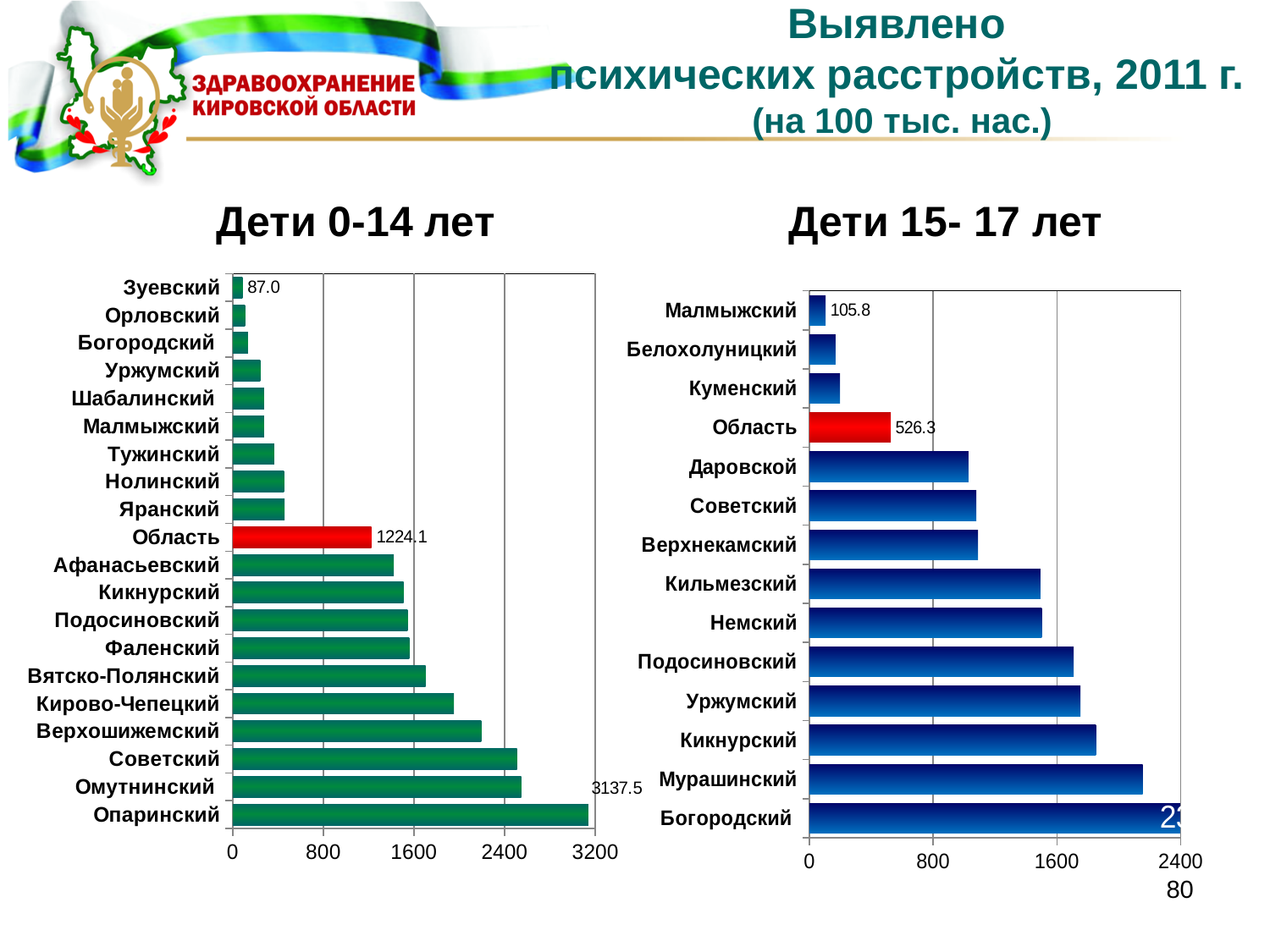
In the chart 'Дети 15- 17 лет', is the value for Даровской greater or less than 800? greater What kind of chart is 'Дети 15- 17 лет'? bar chart In the chart 'Дети 0-14 лет', what is the difference between the values for Опаринский and Зуевский? 3050.5 In the chart 'Дети 15- 17 лет', which category has the lowest value? Малмыжский In the chart 'Дети 0-14 лет', what is the value for Зуевский? 87.0 How many categories are shown in the chart 'Дети 0-14 лет'? 20 In the chart 'Дети 15- 17 лет', what is the value for Область? 526.3 In the chart 'Дети 0-14 лет', which category has the lowest value? Зуевский In the chart 'Дети 0-14 лет', which category has the highest value? Опаринский In the chart 'Дети 0-14 лет', what is the value for Опаринский? 3137.5 In the chart 'Дети 15- 17 лет', what is the value for Малмыжский? 105.8 In the chart 'Дети 0-14 лет', what is the value for Область? 1224.1